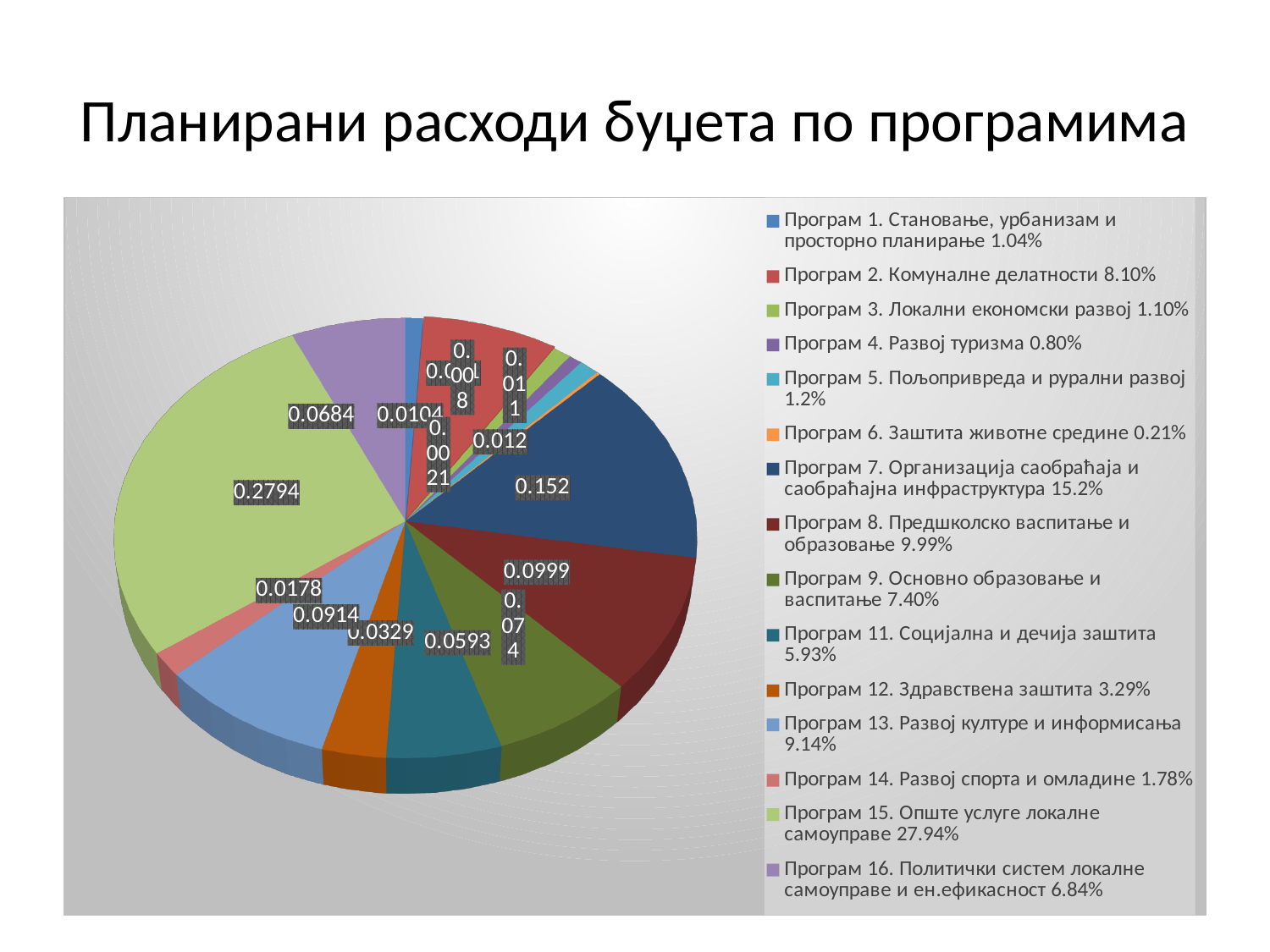
According to the legend, what percentage share does Програм 13. Развој културе и информисања have? 9.14% Which is larger: the slice for Програм 7 (Организација саобраћаја) or the slice for Програм 8 (Предшколско васпитање и образовање)? Програм 7 According to the legend, what percentage share does Програм 11. Социјална и дечија заштита have? 5.93% Which program has the smallest share of the planned budget expenditure? Програм 6. Заштита животне средине What data label is shown on the slice for Програм 15. Опште услуге локалне самоуправе? 0.2794 What kind of chart is shown on the slide? pie chart What data label is shown on the slice for Програм 7. Организација саобраћаја и саобраћајна инфраструктура? 0.152 What is the difference between the data labels for Програм 7 (0.152) and Програм 8 (0.0999)? 0.0521 How many programs (slices) does the legend list? 15 What data label is shown on the slice for Програм 12. Здравствена заштита? 0.0329 What is the title of the chart? Планирани расходи буџета по програмима Which program has the largest share of the planned budget expenditure? Програм 15. Опште услуге локалне самоуправе